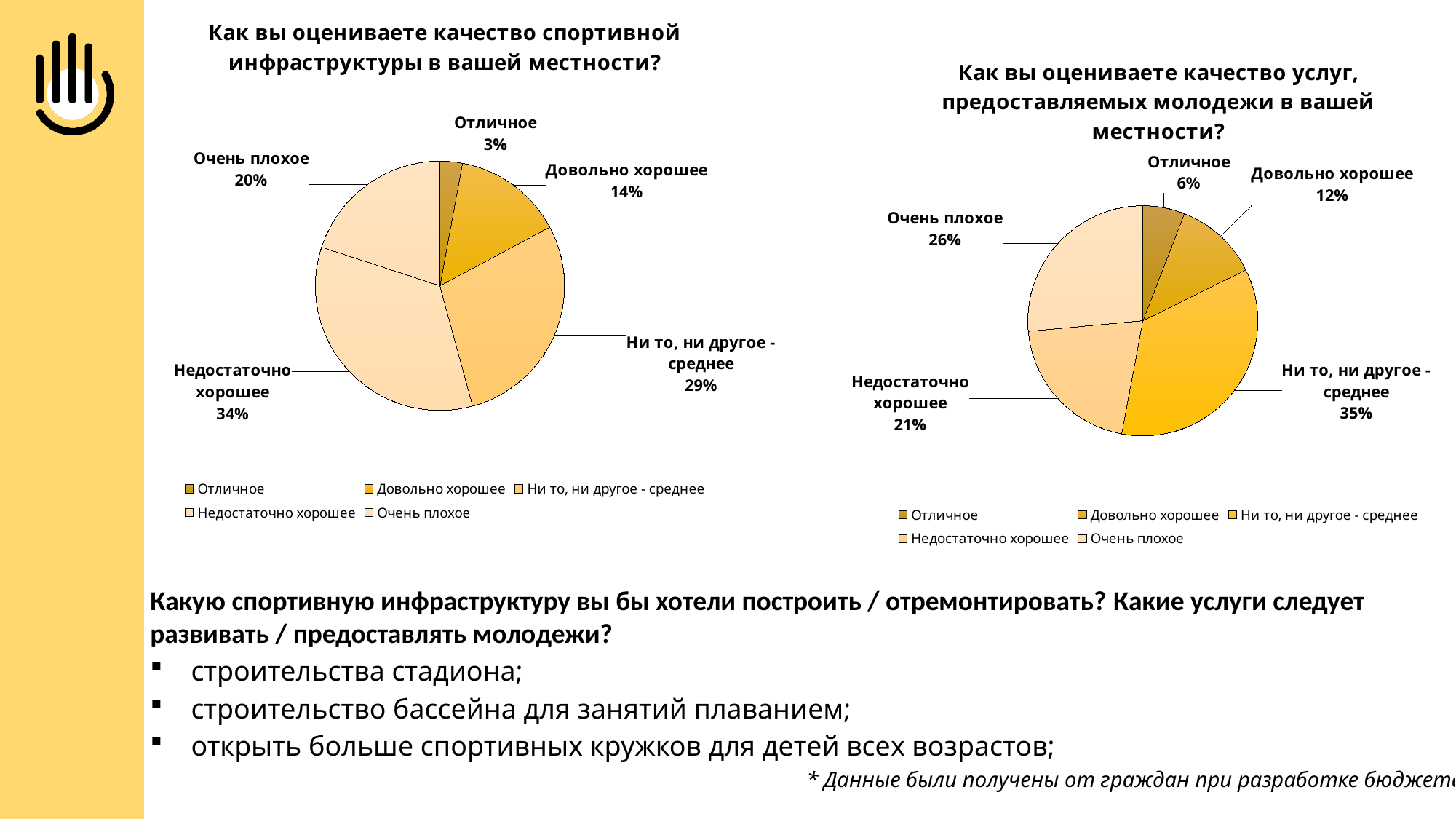
In the left pie chart (sports infrastructure quality), which category has the smallest share? Отличное In the right pie chart (quality of services for youth), which category has the smallest share? Отличное In the left pie chart (sports infrastructure quality), what share of respondents answered "Недостаточно хорошее"? 34% In the right pie chart (quality of services for youth), which is larger: "Очень плохое" or "Недостаточно хорошее"? Очень плохое In the right pie chart (quality of services for youth), which category has the largest share? Ни то, ни другое - среднее In the right pie chart (quality of services for youth), what share of respondents answered "Очень плохое"? 26% How many categories does the left pie chart (sports infrastructure quality) show? 5 In the right pie chart (quality of services for youth), what share of respondents answered "Ни то, ни другое - среднее"? 35% What type of chart is used on the right side of the slide (quality of services for youth)? Pie chart In the left pie chart (sports infrastructure quality), which category has the largest share? Недостаточно хорошее In the left pie chart (sports infrastructure quality), what share of respondents answered "Отличное"? 3% In the left pie chart (sports infrastructure quality), what is the difference in percentage points between "Ни то, ни другое - среднее" and "Довольно хорошее"? 15